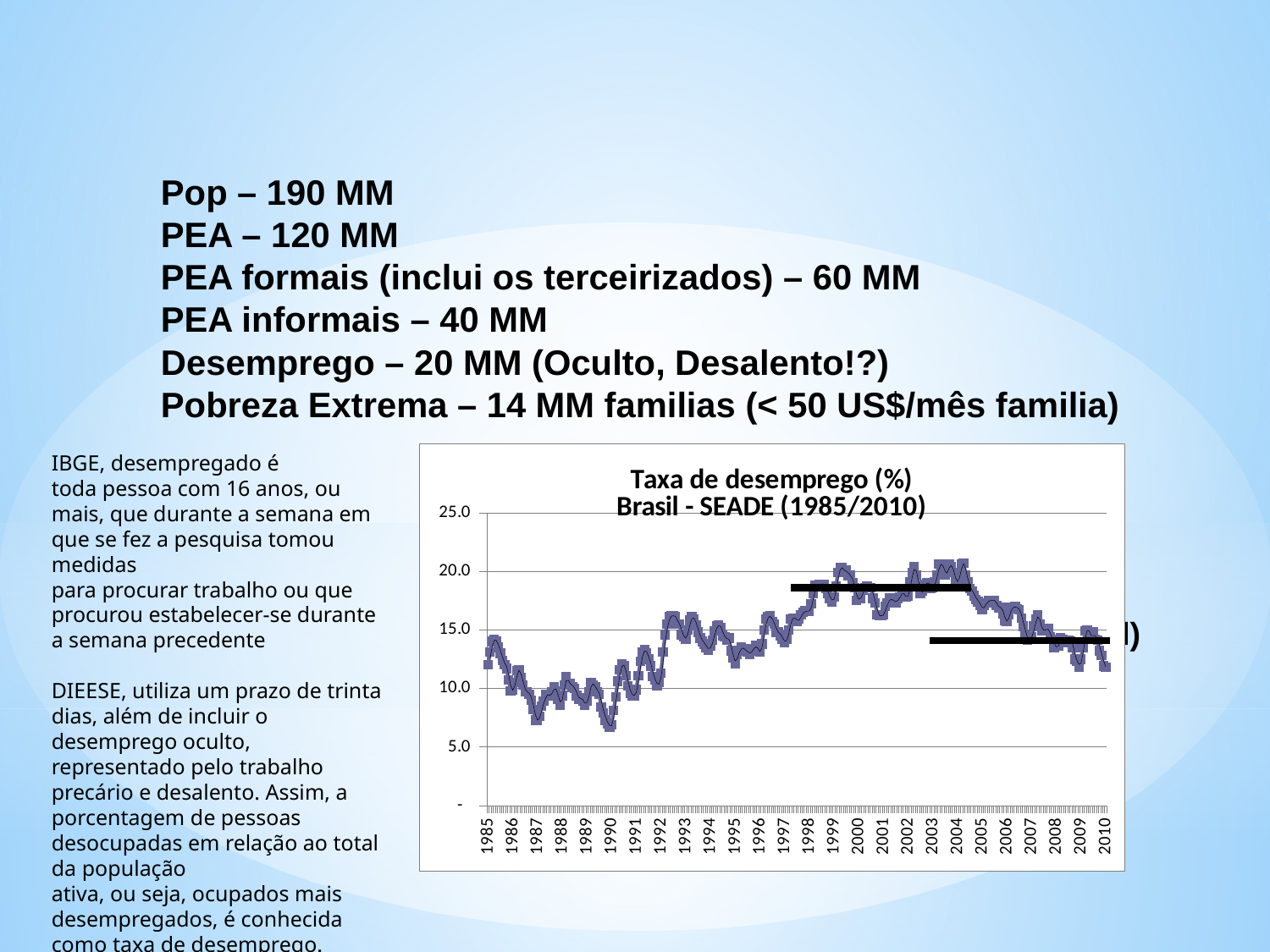
What is the highest value shown on the chart's vertical axis? 25.0 What kind of chart is shown on the slide? line chart Does the unemployment rate rise or fall between 2004 and 2010? fall Is the unemployment rate around 1990 greater or less than 10.0? less How many year labels are shown on the x axis? 26 Is the unemployment rate higher around 2003 or around 1990? around 2003 Is the unemployment rate around 2003 greater or less than 15.0? greater Does the unemployment rate rise or fall between 1990 and 1999? rise Is the unemployment rate around 2010 greater or less than 15.0? less What is the title of the chart? Taxa de desemprego (%) Brasil - SEADE (1985/2010)